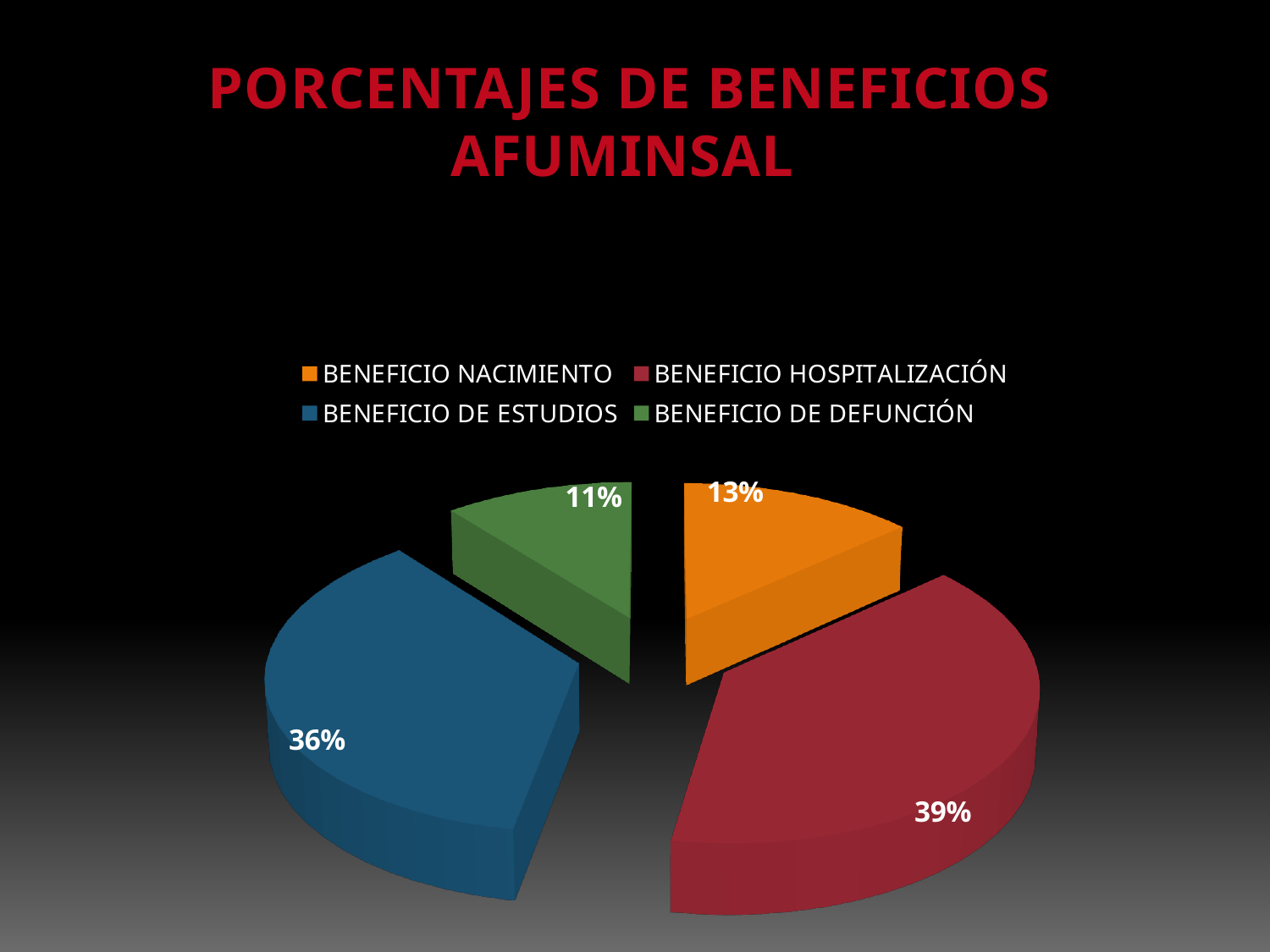
What percentage does BENEFICIO DE DEFUNCIÓN represent? 11% What type of chart is shown on the slide? Pie chart What is the title of the chart on the slide? PORCENTAJES DE BENEFICIOS AFUMINSAL Which benefit has the smallest share of the pie? BENEFICIO DE DEFUNCIÓN How many slices does the pie chart have? 4 What is the difference in percentage points between BENEFICIO HOSPITALIZACIÓN and BENEFICIO DE ESTUDIOS? 3 Which colour represents BENEFICIO DE ESTUDIOS in the pie chart? Blue What percentage does BENEFICIO DE ESTUDIOS represent? 36% Which benefit has the largest share of the pie? BENEFICIO HOSPITALIZACIÓN Which is larger, the share for BENEFICIO NACIMIENTO or BENEFICIO DE DEFUNCIÓN? BENEFICIO NACIMIENTO What percentage does BENEFICIO NACIMIENTO represent? 13% What percentage does BENEFICIO HOSPITALIZACIÓN represent in the pie chart? 39%